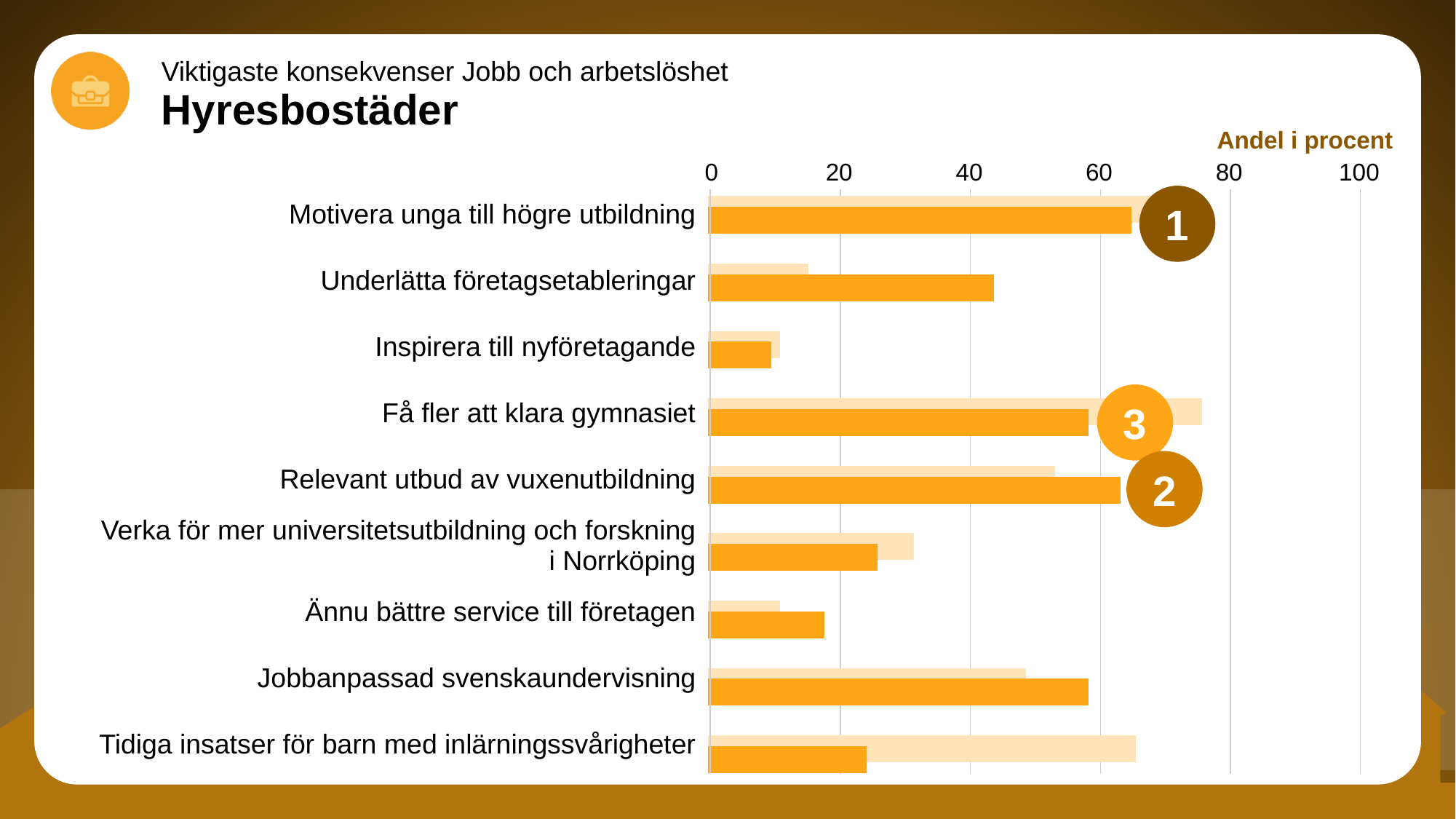
Is the dark orange value for Verka för mer universitetsutbildning och forskning i Norrköping greater or less than 20? greater Which has the larger dark orange bar: Underlätta företagsetableringar or Verka för mer universitetsutbildning och forskning i Norrköping? Underlätta företagsetableringar Which has the larger dark orange bar: Jobbanpassad svenskaundervisning or Tidiga insatser för barn med inlärningssvårigheter? Jobbanpassad svenskaundervisning What label is shown above the horizontal axis of the chart? Andel i procent Which category has the longest dark orange bar? Motivera unga till högre utbildning Is the dark orange value for Inspirera till nyföretagande greater or less than 20? less Is the light orange value for Tidiga insatser för barn med inlärningssvårigheter greater or less than 60? greater What kind of chart is shown on the slide? bar chart How many categories are listed on the chart? 9 Which category has the shortest dark orange bar? Inspirera till nyföretagande